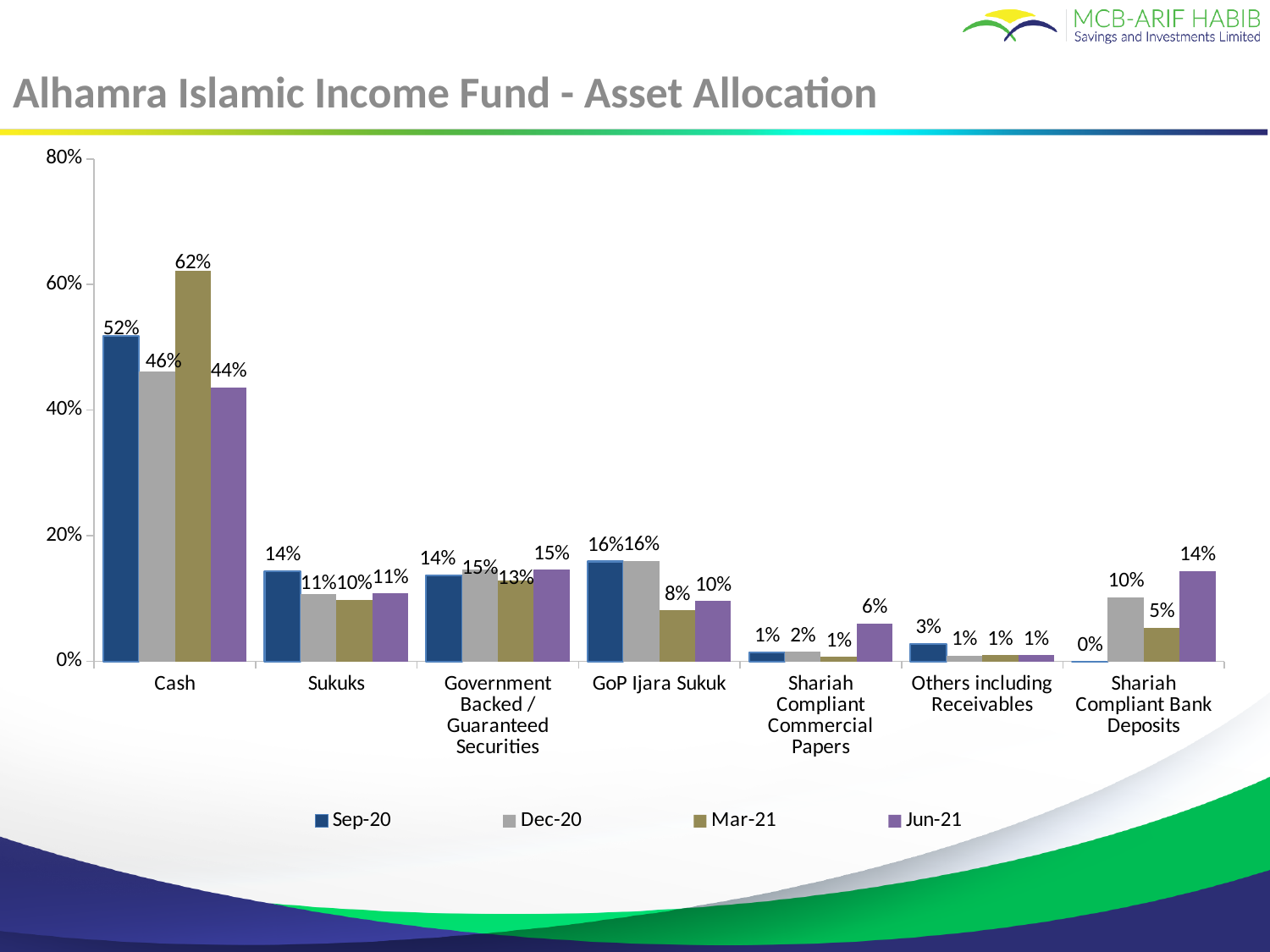
Which category has the highest Jun-21 value? Cash What is the Sep-20 value for GoP Ijara Sukuk? 16% What is the Dec-20 value for Government Backed / Guaranteed Securities? 15% What is the difference between the Mar-21 and Jun-21 values for Cash? 18% How many categories are shown on the x axis? 7 What kind of chart is shown on the slide? Bar chart Which category has the lowest Sep-20 value? Shariah Compliant Bank Deposits Is the Sep-20 value for Cash greater or less than 40%? greater Which is larger for Sukuks: the Sep-20 value or the Mar-21 value? Sep-20 How many series does the legend list? 4 What is the Jun-21 value for Shariah Compliant Bank Deposits? 14% What is the Mar-21 value for Cash? 62%